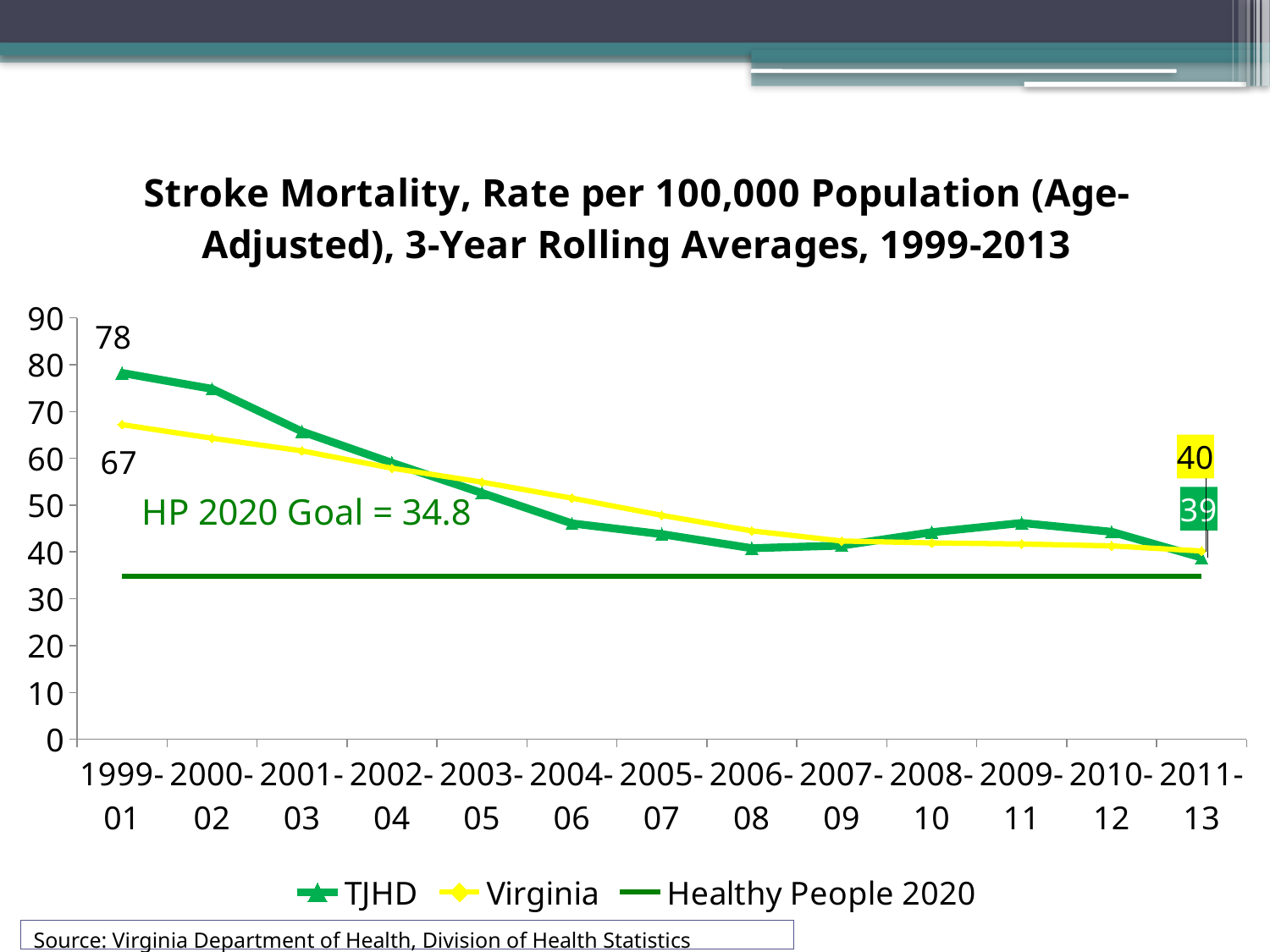
How many series does the legend list? 3 What is the Healthy People 2020 goal value shown on the chart? 34.8 What is the difference between the TJHD and Virginia rates for 1999-01? 11 What is the Virginia stroke mortality rate for 1999-01? 67 What is the TJHD stroke mortality rate for 1999-01? 78 What kind of chart is shown on the slide? line chart How many 3-year periods are shown on the x axis? 13 Is the TJHD value for 2006-08 greater or less than 50? less Which series had the higher rate in 1999-01, TJHD or Virginia? TJHD What is the TJHD stroke mortality rate for 2011-13? 39 What is the Virginia stroke mortality rate for 2011-13? 40 By how much did the TJHD rate fall from 1999-01 to 2011-13? 39